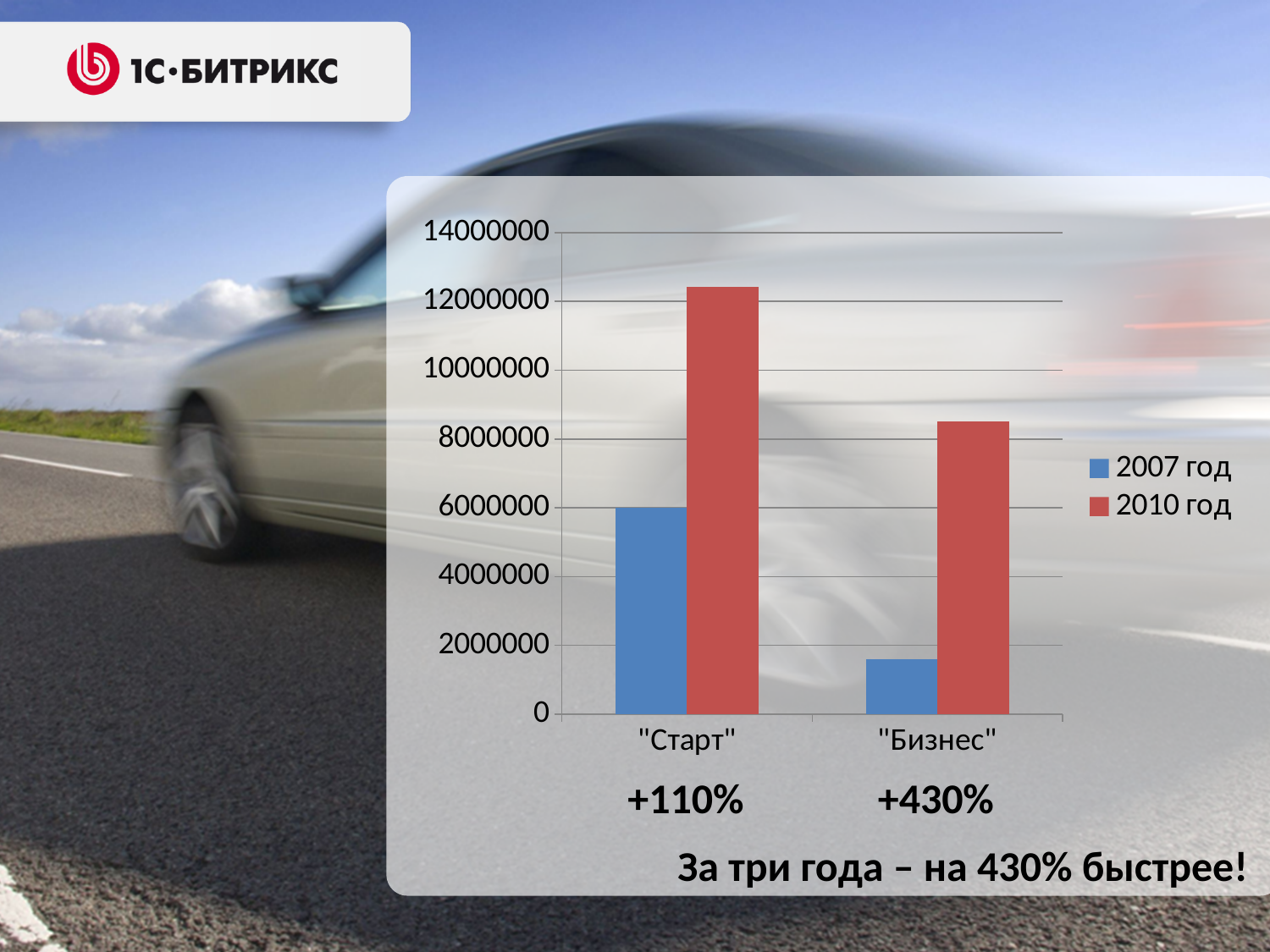
Is the 2007 год value for "Бизнес" greater or less than 2000000? less Which bar is the lowest in the whole chart? "Бизнес", 2007 год What percentage growth is printed below the "Бизнес" category? +430% Which category has the higher value for the 2010 год series? "Старт" Is the 2010 год value for "Бизнес" greater or less than 8000000? greater Is the 2010 год value for "Старт" greater or less than 12000000? greater How many series does the chart legend list? 2 How many categories are shown on the x axis of the chart? 2 For "Бизнес", which series has the larger value: 2007 год or 2010 год? 2010 год What are the two entries listed in the chart legend? 2007 год, 2010 год For the 2007 год series, which is larger: "Старт" or "Бизнес"? "Старт" What kind of chart is shown on the slide? bar chart